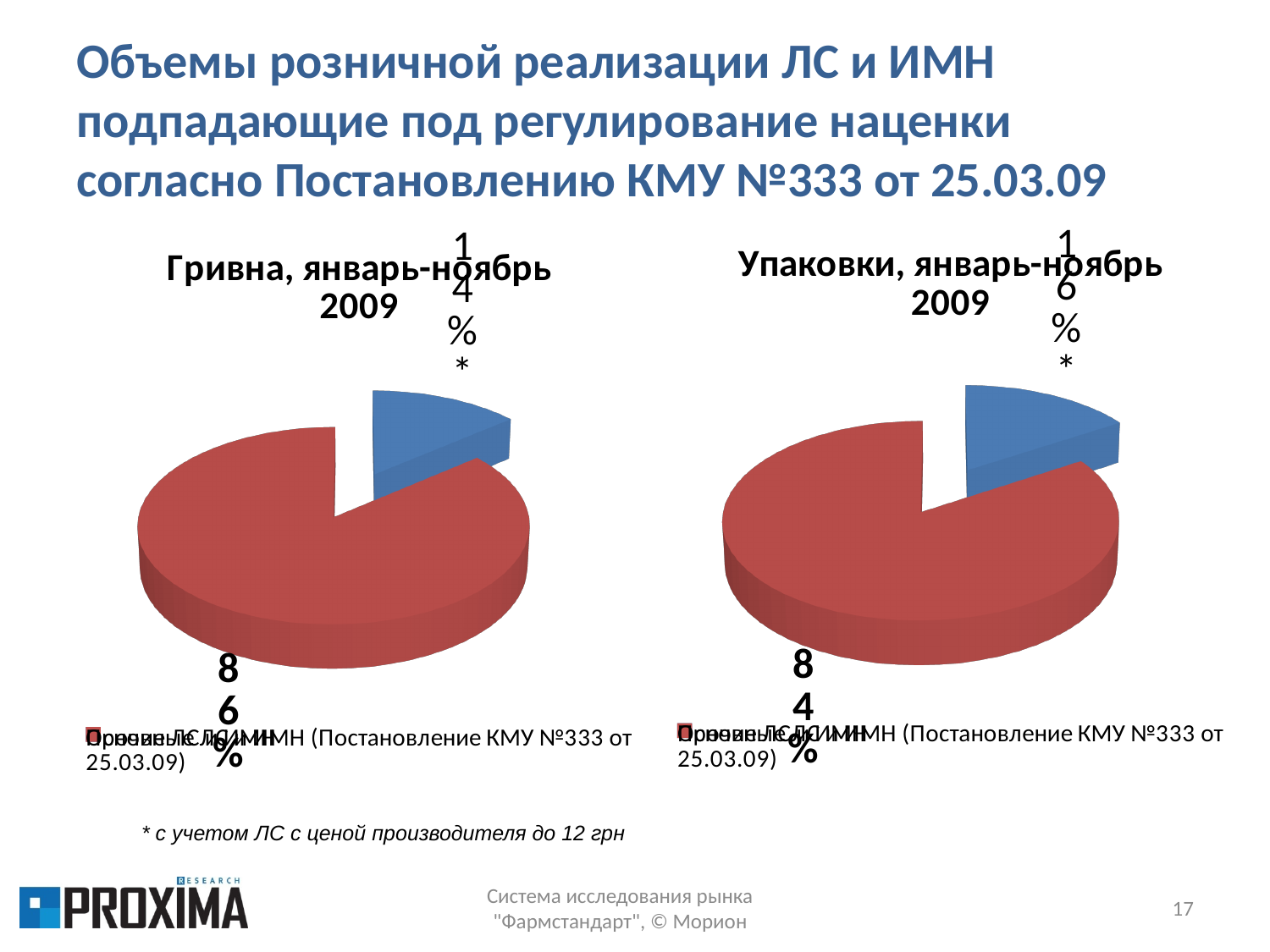
How many slices does the chart titled "Гривна, январь-ноябрь 2009" have? 2 What kind of chart is the chart titled "Гривна, январь-ноябрь 2009"? Pie chart In the chart titled "Гривна, январь-ноябрь 2009", what percentage is shown for the blue slice? 14% In the chart titled "Упаковки, январь-ноябрь 2009", what percentage is shown for the blue slice? 16% Is the blue slice larger in the chart titled "Гривна, январь-ноябрь 2009" or in the chart titled "Упаковки, январь-ноябрь 2009"? Упаковки, январь-ноябрь 2009 (16% vs 14%) In the chart titled "Упаковки, январь-ноябрь 2009", what percentage is shown for the red slice? 84% In the chart titled "Гривна, январь-ноябрь 2009", which slice is larger, the red one or the blue one? The red one In the chart titled "Упаковки, январь-ноябрь 2009", which slice is the smallest? The blue slice (16%) In the chart titled "Упаковки, январь-ноябрь 2009", what is the difference in percentage points between the red slice and the blue slice? 68 percentage points In the chart titled "Гривна, январь-ноябрь 2009", what percentage is shown for the red slice? 86% How many charts are shown on the slide? 2 In the chart titled "Гривна, январь-ноябрь 2009", what is the difference in percentage points between the red slice and the blue slice? 72 percentage points